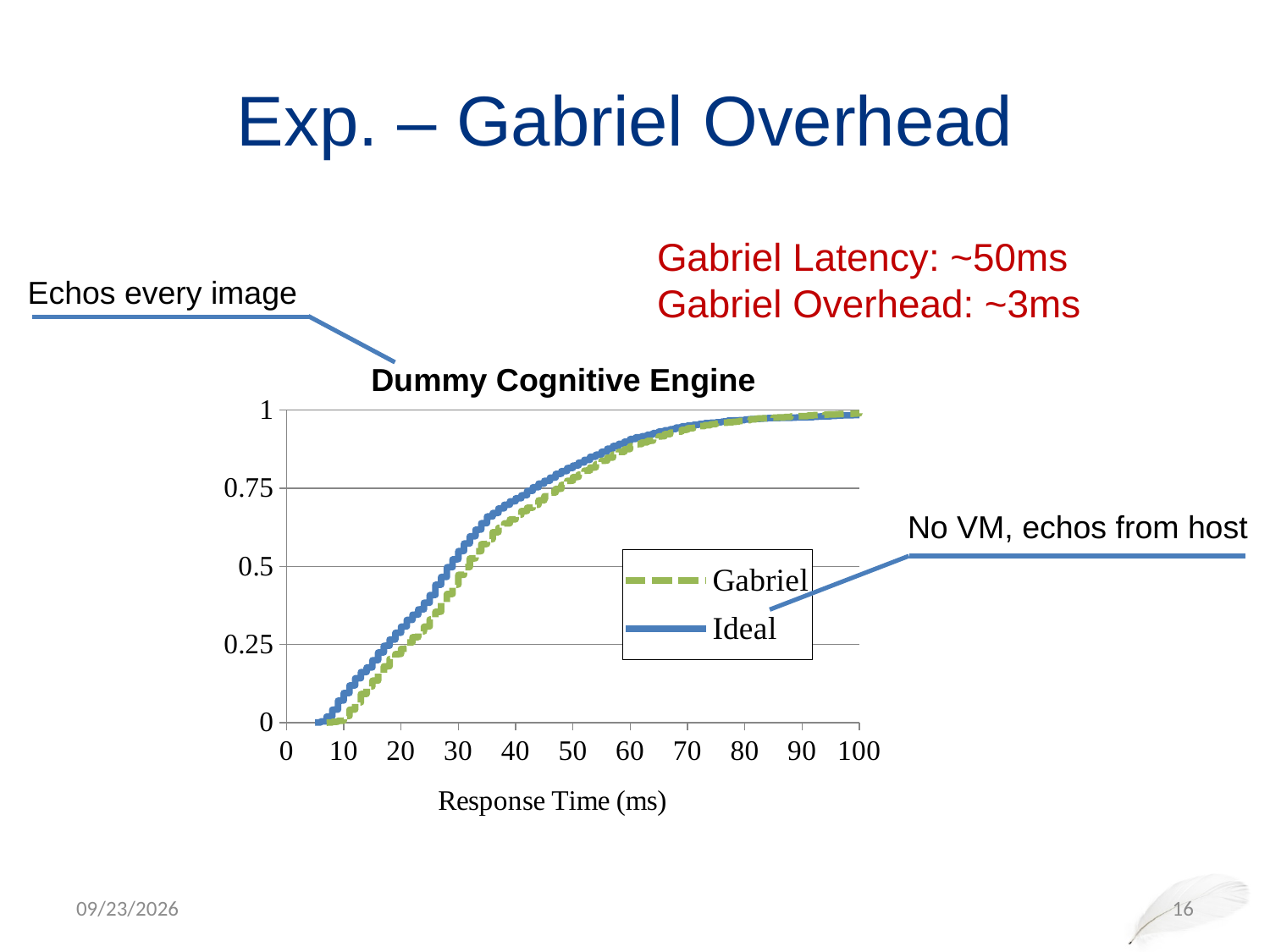
At a response time of 20 ms, which series has the lower value, Gabriel or Ideal? Gabriel Is the value of the Ideal series at 40 ms greater or less than 0.5? greater What is the title of the chart? Dummy Cognitive Engine Is the value of the Gabriel series at 10 ms greater or less than 0.25? less Do the values of the Ideal series rise or fall as response time increases along the x axis? rise Do the values of the Gabriel series rise or fall as response time increases along the x axis? rise What kind of chart is shown on the slide? line chart Is the value of the Gabriel series at 60 ms greater or less than 0.75? greater How many series does the legend of the chart list? 2 At a response time of 30 ms, which series has the higher value, Gabriel or Ideal? Ideal What is the label of the x axis of the chart? Response Time (ms)